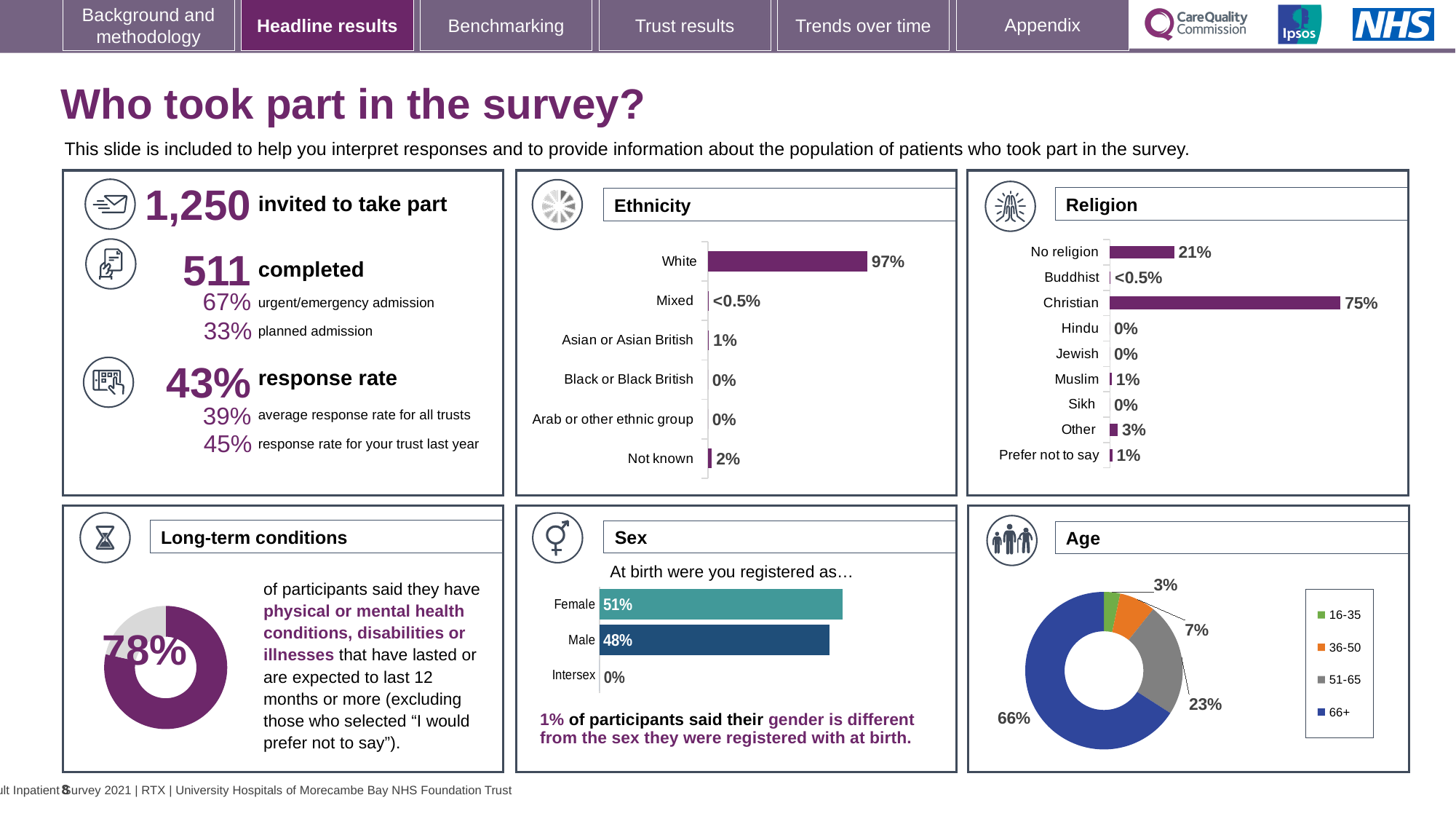
In the Age chart, how many age groups does the legend list? 4 In the Ethnicity chart, what is the value for Not known? 2% In the Sex chart, what is the difference between the Female and Male percentages? 3% In the Age chart, what share of participants were aged 66+? 66% What kind of chart is used for the Age breakdown? Donut (pie) chart In the Ethnicity chart, which ethnic group has the highest percentage? White In the Religion chart, what percentage of participants were Christian? 75% In the Religion chart, which is larger, Other or Muslim? Other In the Religion chart, what is the difference between the Christian and No religion percentages? 54% In the Ethnicity chart, what percentage of participants were White? 97% In the Sex chart, what percentage of participants were registered as Female at birth? 51% In the Religion chart, how many religion categories are shown? 9